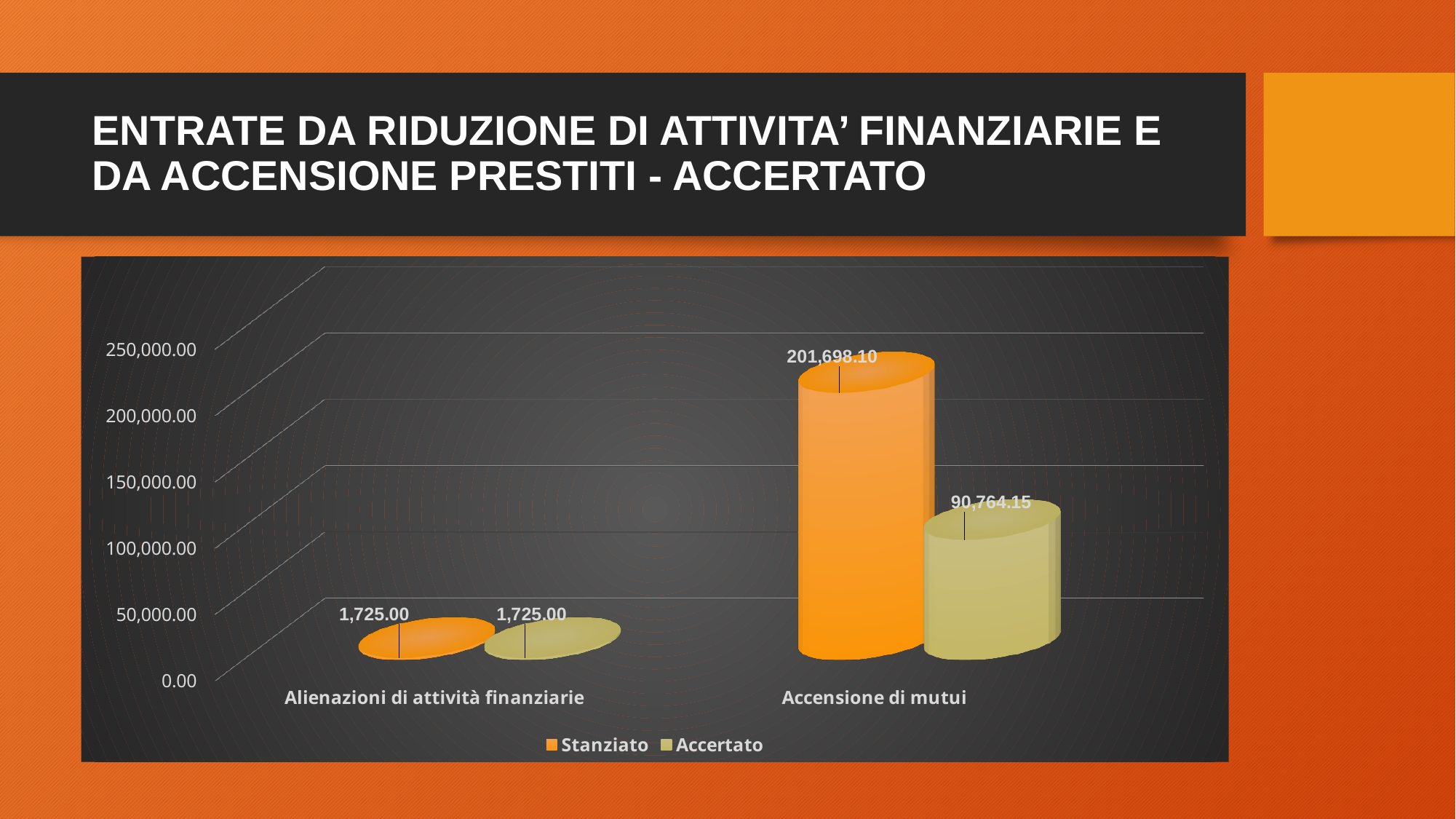
How many series does the legend list? 2 Is the Stanziato value for Accensione di mutui greater or less than 200,000.00? greater Which category has the highest Stanziato value? Accensione di mutui Which category has the lowest Accertato value? Alienazioni di attività finanziarie What kind of chart is shown on the slide? Bar chart What is the Accertato value for Alienazioni di attività finanziarie? 1,725.00 How many categories are shown on the x axis? 2 What is the Accertato value for Accensione di mutui? 90,764.15 What is the difference between the Stanziato and Accertato values for Accensione di mutui? 110,933.95 What is the Stanziato value for Accensione di mutui? 201,698.10 What is the Stanziato value for Alienazioni di attività finanziarie? 1,725.00 For Accensione di mutui, which is larger: Stanziato or Accertato? Stanziato